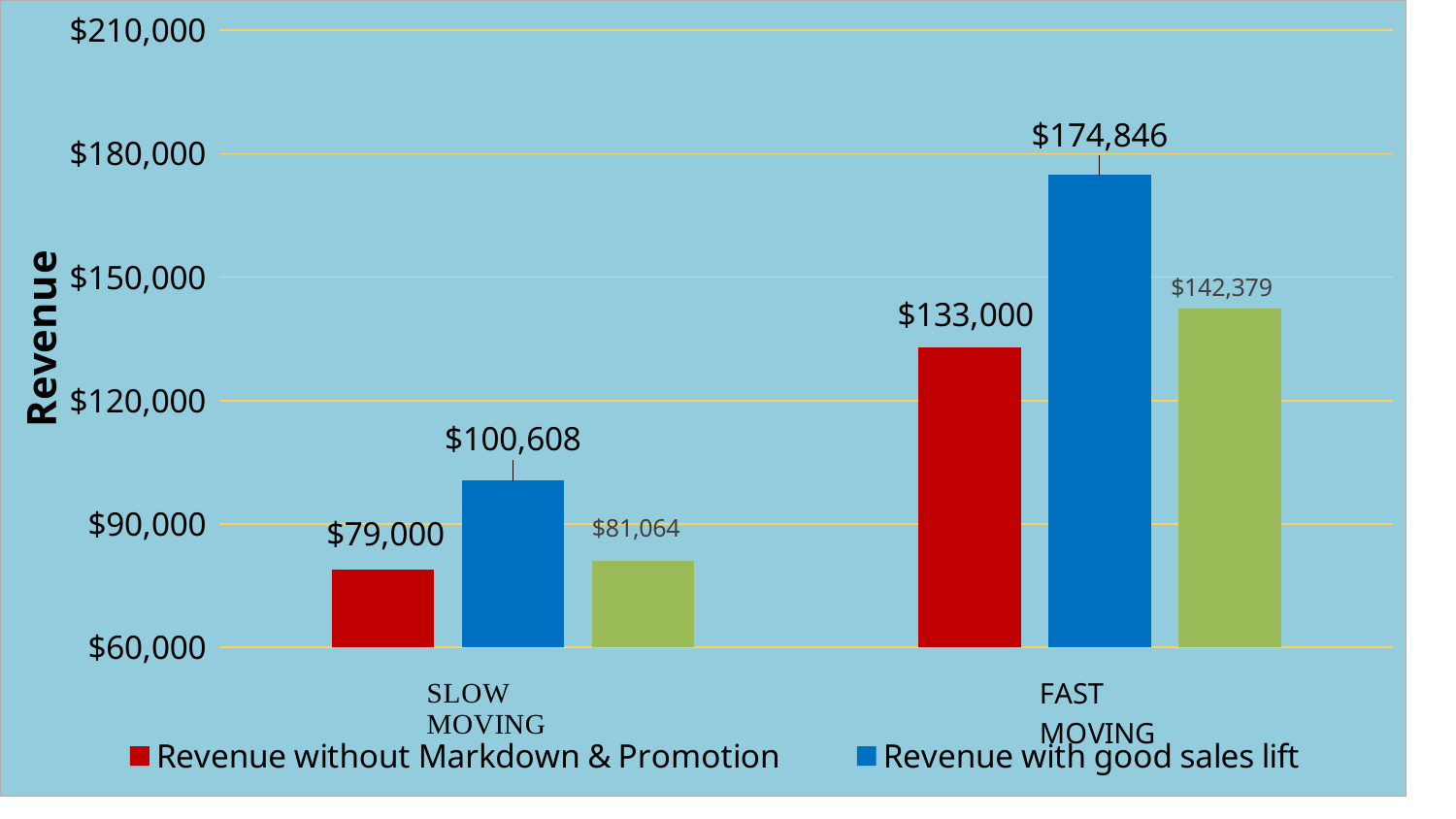
What type of chart is shown on the slide? Bar chart How many categories are shown on the x axis? 2 How many series does the legend list? 2 What is the Revenue without Markdown & Promotion for FAST MOVING? $133,000 Which bar on the chart has the highest value? Revenue with good sales lift for FAST MOVING What value is shown on the green bar for FAST MOVING? $142,379 Which bar on the chart has the lowest value? Revenue without Markdown & Promotion for SLOW MOVING Which is larger for SLOW MOVING: Revenue with good sales lift or Revenue without Markdown & Promotion? Revenue with good sales lift What is the difference between Revenue with good sales lift and Revenue without Markdown & Promotion for FAST MOVING? $41,846 What is the Revenue with good sales lift for SLOW MOVING? $100,608 What is the Revenue with good sales lift for FAST MOVING? $174,846 What is the Revenue without Markdown & Promotion for SLOW MOVING? $79,000